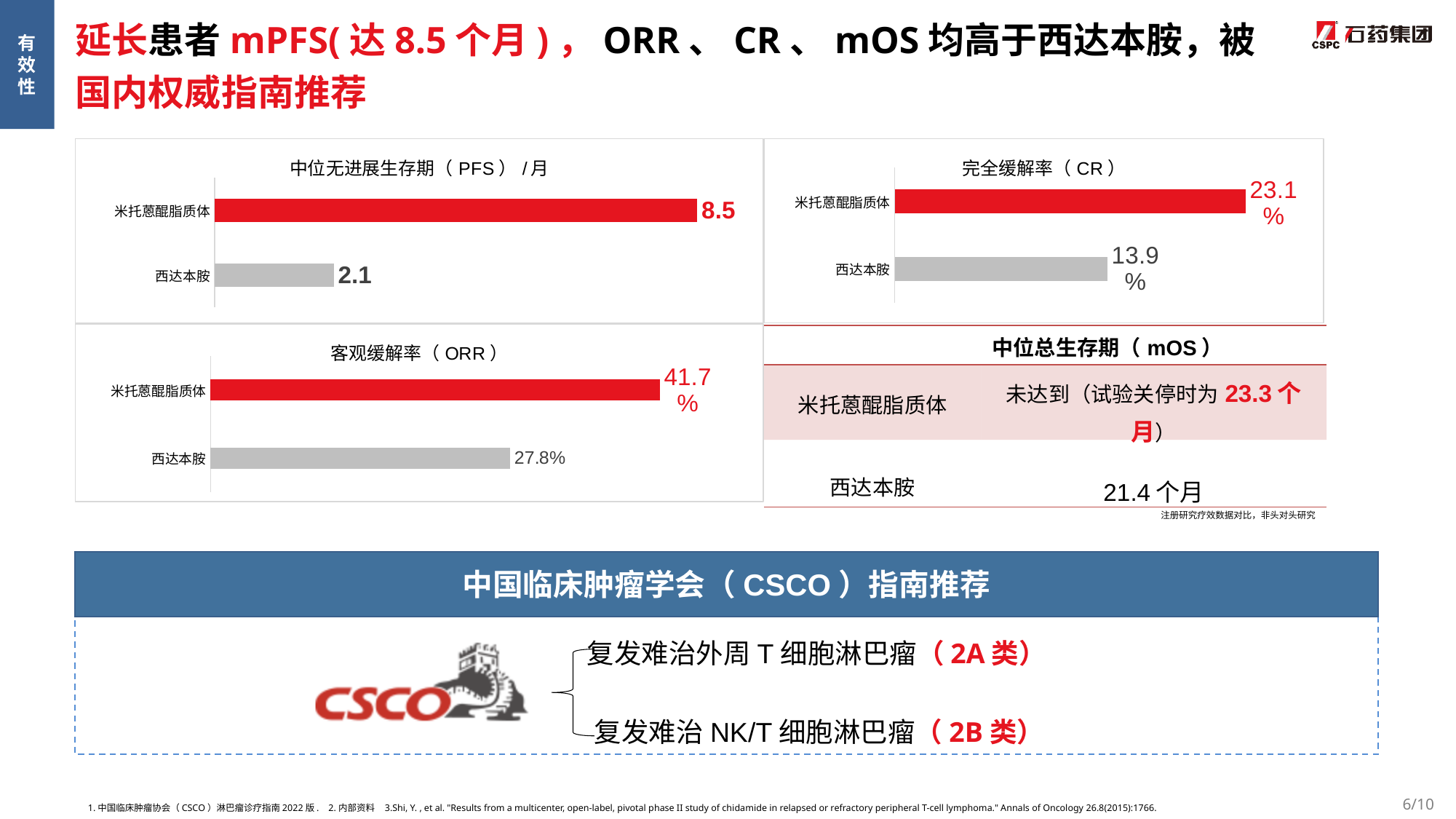
In the 客观缓解率（ORR） chart, what is the value for 米托蒽醌脂质体? 41.7% In the 中位无进展生存期（PFS）/月 chart, what is the value for 米托蒽醌脂质体? 8.5 In the 完全缓解率（CR） chart, what is the value for 西达本胺? 13.9% In the 完全缓解率（CR） chart, what is the difference between 米托蒽醌脂质体 and 西达本胺? 9.2% In the 客观缓解率（ORR） chart, what is the value for 西达本胺? 27.8% In the 客观缓解率（ORR） chart, which category has the highest value? 米托蒽醌脂质体 In the 中位无进展生存期（PFS）/月 chart, what is the value for 西达本胺? 2.1 In the 完全缓解率（CR） chart, which category has the lowest value? 西达本胺 In the 完全缓解率（CR） chart, what is the value for 米托蒽醌脂质体? 23.1% How many categories are shown in the 中位无进展生存期（PFS）/月 chart? 2 What kind of chart is the 客观缓解率（ORR） chart? Bar chart In the 中位无进展生存期（PFS）/月 chart, what is the difference between 米托蒽醌脂质体 and 西达本胺? 6.4